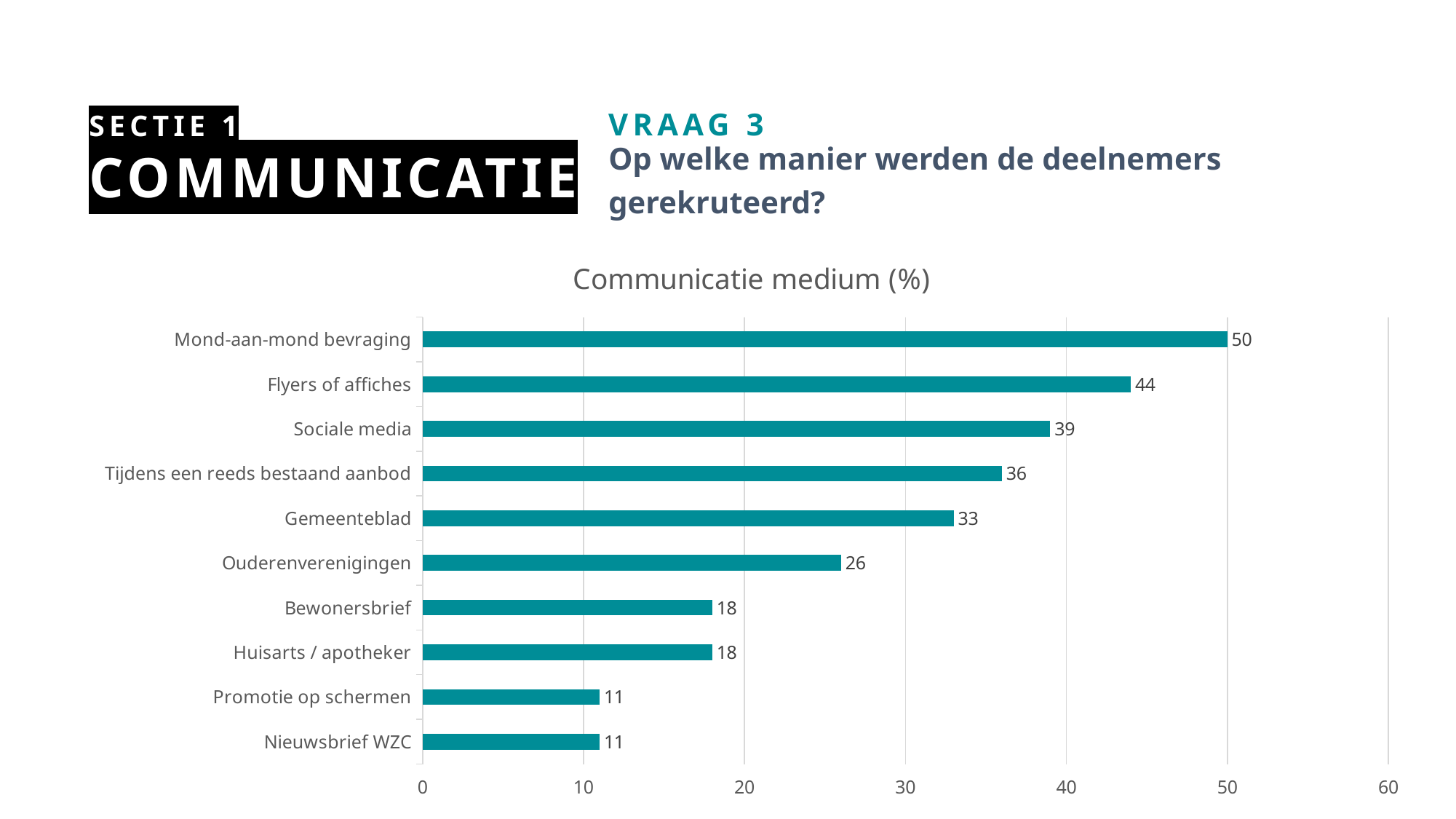
Which is larger, the value for Sociale media or the value for Gemeenteblad? Sociale media What is the difference between the values for Tijdens een reeds bestaand aanbod and Bewonersbrief? 18 What is the highest value shown on the x axis? 60 What is the difference between the values for Mond-aan-mond bevraging and Flyers of affiches? 6 How many categories are shown in the chart? 10 Is the value for Ouderenverenigingen greater or less than 30? less What kind of chart is shown on the slide? bar chart Which category has the highest value? Mond-aan-mond bevraging What is the value for Sociale media? 39 What is the value for Ouderenverenigingen? 26 What is the title of the chart? Communicatie medium (%) What is the value for Gemeenteblad? 33